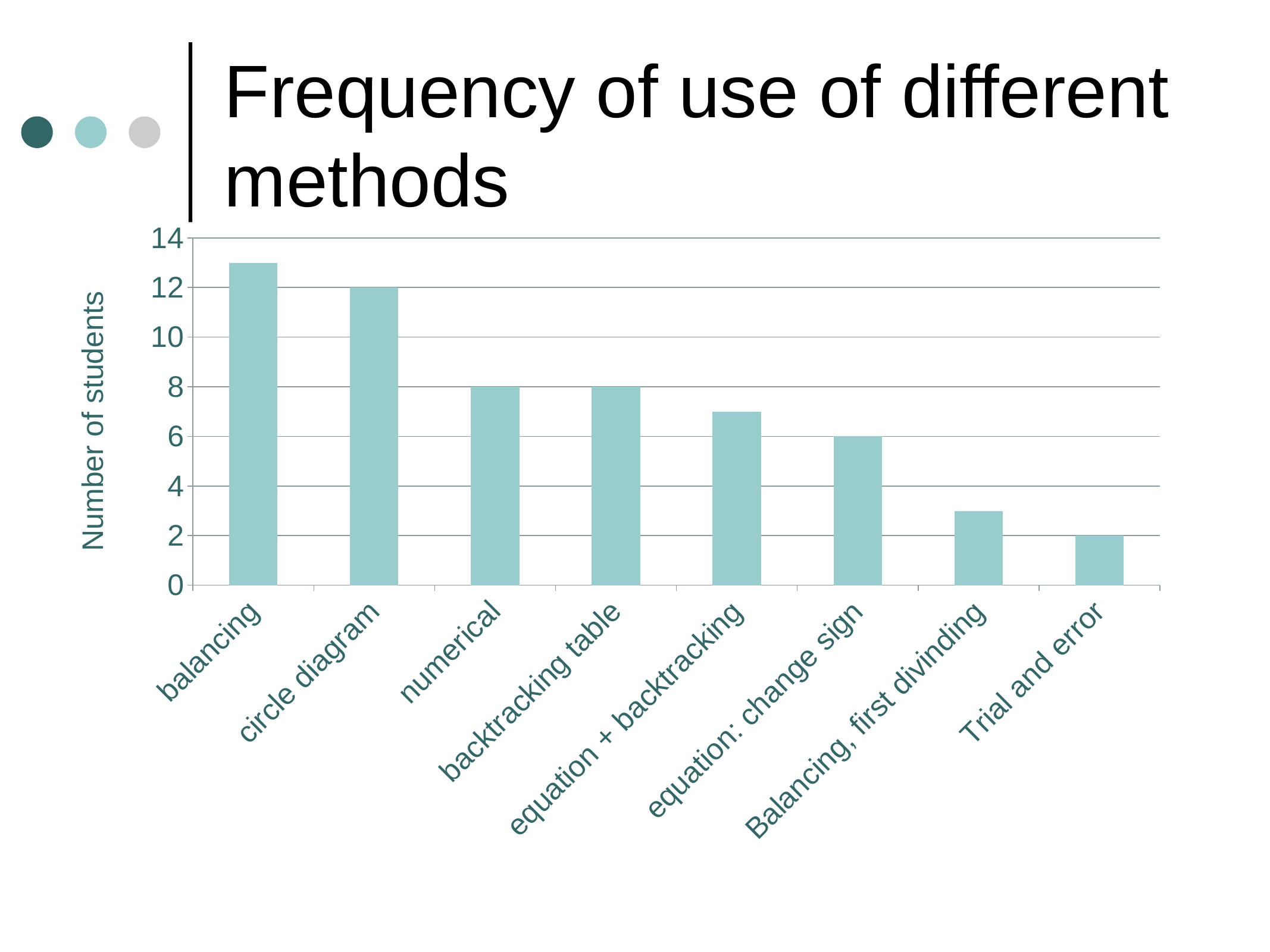
What kind of chart is shown on the slide? bar chart How many students used the numerical method? 8 How many methods (categories) are shown on the chart? 8 Which method has the lowest number of students? Trial and error What is the difference between the number of students for circle diagram and for Trial and error? 10 How many students used the circle diagram method? 12 How many students used the equation: change sign method? 6 Do the values rise or fall from left to right across the chart? fall Is the value for balancing greater or less than 12? greater Which method has the highest number of students? balancing Is the value for Balancing, first dividing greater or less than 4? less How many students used Trial and error? 2